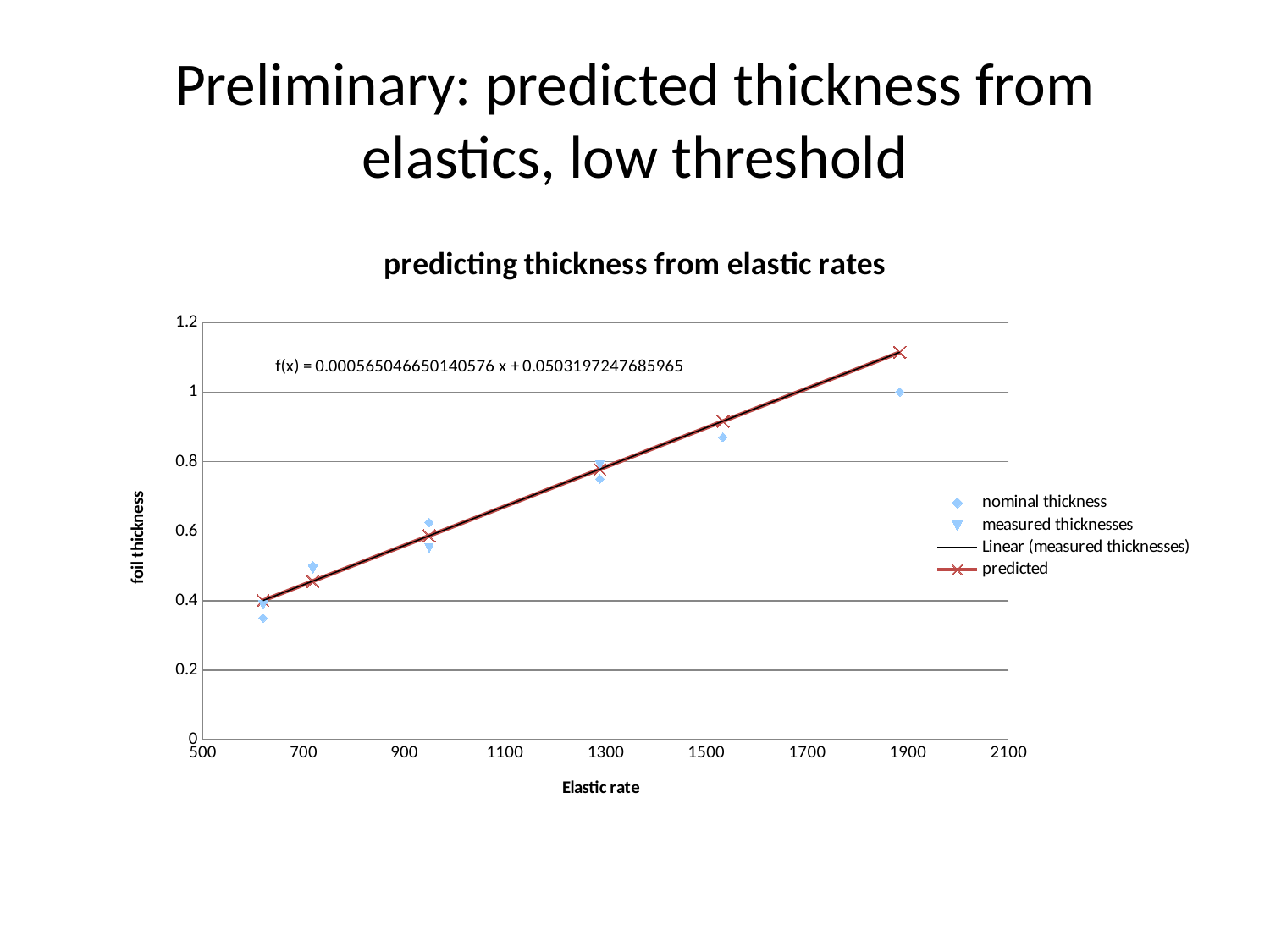
Do the predicted values rise or fall as the elastic rate increases? rise Is the nominal thickness at the lowest elastic rate greater or less than 0.4? less What kind of chart is shown on the slide? scatter chart How many nominal thickness points are plotted? 6 What is the label of the x axis? Elastic rate At the highest elastic rate, which is larger: the predicted value or the nominal thickness? predicted At the lowest elastic rate, which is larger: the predicted value or the nominal thickness? predicted How many series does the legend list? 4 Is the predicted value at an elastic rate of about 1530 greater or less than 0.8? greater What is the title of the chart? predicting thickness from elastic rates Which series reaches the highest foil thickness on the chart? predicted Is the predicted value at the highest elastic rate greater or less than 1? greater